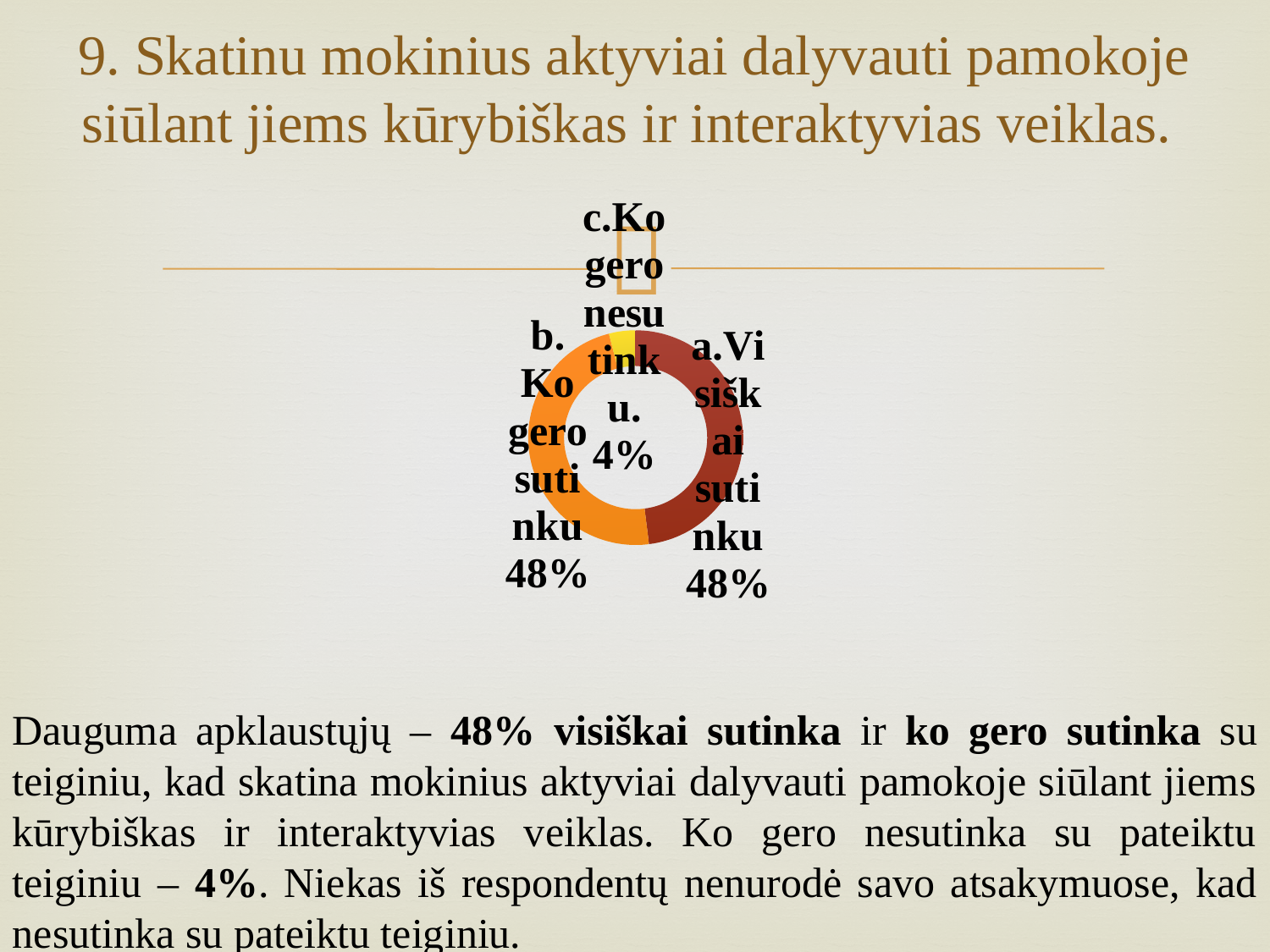
How many categories are shown in the chart? 3 What kind of chart is shown on the slide? Doughnut (pie) chart What colour is the slice for "b. Ko gero sutinku"? Orange What percentage of respondents chose "a. Visiškai sutinku"? 48% Which category has the smallest share of the chart? c. Ko gero nesutinku Is the share for "c. Ko gero nesutinku" greater or less than 10%? less What percentage of respondents chose "c. Ko gero nesutinku"? 4% What is the difference in percentage points between "a. Visiškai sutinku" and "c. Ko gero nesutinku"? 44 percentage points What percentage of respondents chose "b. Ko gero sutinku"? 48% Which is larger: the share for "b. Ko gero sutinku" or for "c. Ko gero nesutinku"? b. Ko gero sutinku What colour is the slice for "c. Ko gero nesutinku"? Yellow What is the combined share of "a. Visiškai sutinku" and "b. Ko gero sutinku"? 96%